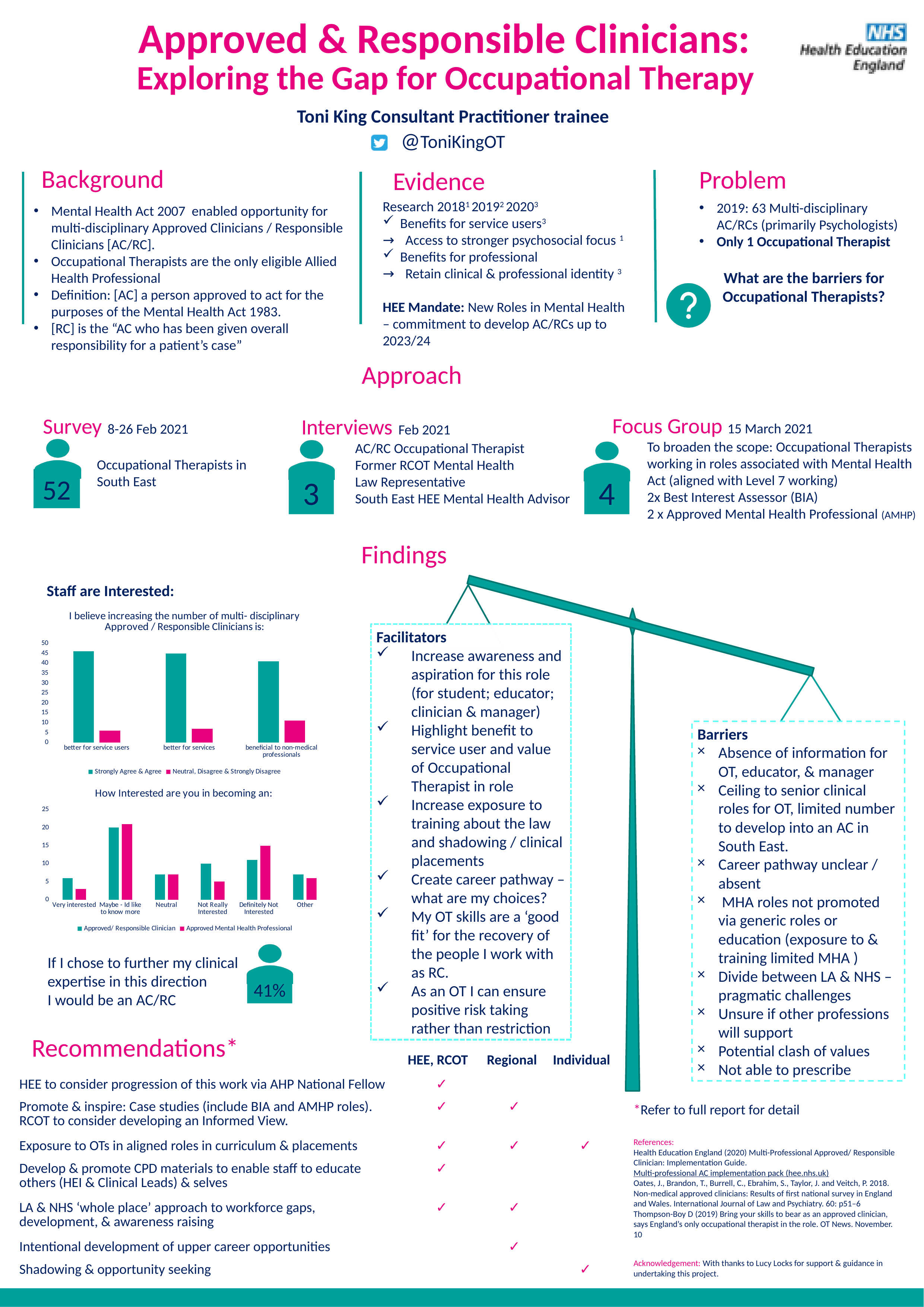
In the 'I believe increasing the number of multi- disciplinary Approved / Responsible Clinicians is:' chart, is the 'Neutral, Disagree & Strongly Disagree' value for 'better for services' greater or less than 10? less In the 'I believe increasing the number of multi- disciplinary Approved / Responsible Clinicians is:' chart, which category has the highest 'Neutral, Disagree & Strongly Disagree' value? beneficial to non-medical professionals In the 'I believe increasing the number of multi- disciplinary Approved / Responsible Clinicians is:' chart, which category has the lowest 'Strongly Agree & Agree' value? beneficial to non-medical professionals In the 'How Interested are you in becoming an:' chart, which category has the highest 'Approved/ Responsible Clinician' value? Maybe - Id like to know more In the 'How Interested are you in becoming an:' chart, for 'Definitely Not Interested', which series has the larger value: 'Approved/ Responsible Clinician' or 'Approved Mental Health Professional'? Approved Mental Health Professional How many categories are shown on the x axis of the 'How Interested are you in becoming an:' chart? 6 In the 'How Interested are you in becoming an:' chart, is the 'Approved/ Responsible Clinician' value for 'Maybe - Id like to know more' greater or less than 15? greater What colour are the 'Approved Mental Health Professional' bars in the 'How Interested are you in becoming an:' chart? pink In the 'How Interested are you in becoming an:' chart, which category has the lowest 'Approved Mental Health Professional' value? Very interested What kind of chart is the 'I believe increasing the number of multi- disciplinary Approved / Responsible Clinicians is:' chart? bar chart In the 'I believe increasing the number of multi- disciplinary Approved / Responsible Clinicians is:' chart, is the 'Strongly Agree & Agree' value for 'better for service users' greater or less than 40? greater How many series does the legend of the 'I believe increasing the number of multi- disciplinary Approved / Responsible Clinicians is:' chart list? 2